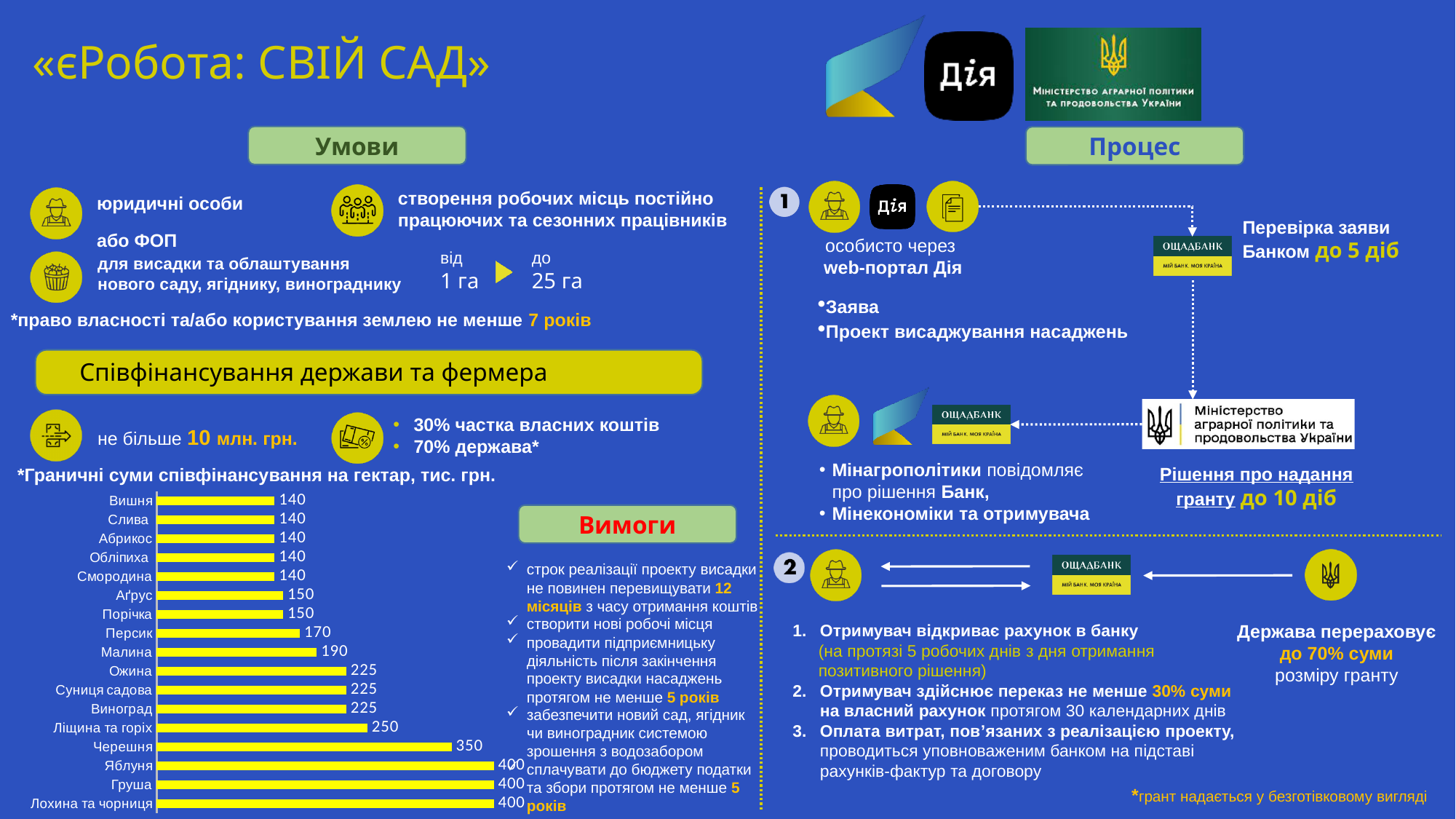
How many categories are shown in the bar chart? 17 What is the value for Ліщина та горіх in the bar chart? 250 What kind of chart is shown on the slide? Bar chart Which has a larger value in the bar chart, Малина or Ожина? Ожина What is the value for Персик in the bar chart? 170 What is the highest value shown in the bar chart? 400 What is the value for Малина in the bar chart? 190 What is the difference between the values for Черешня and Персик in the bar chart? 180 What is the title of the bar chart on the slide? Граничні суми співфінансування на гектар, тис. грн. What is the lowest value shown in the bar chart? 140 What is the value for Аґрус in the bar chart? 150 What is the value for Черешня in the bar chart? 350